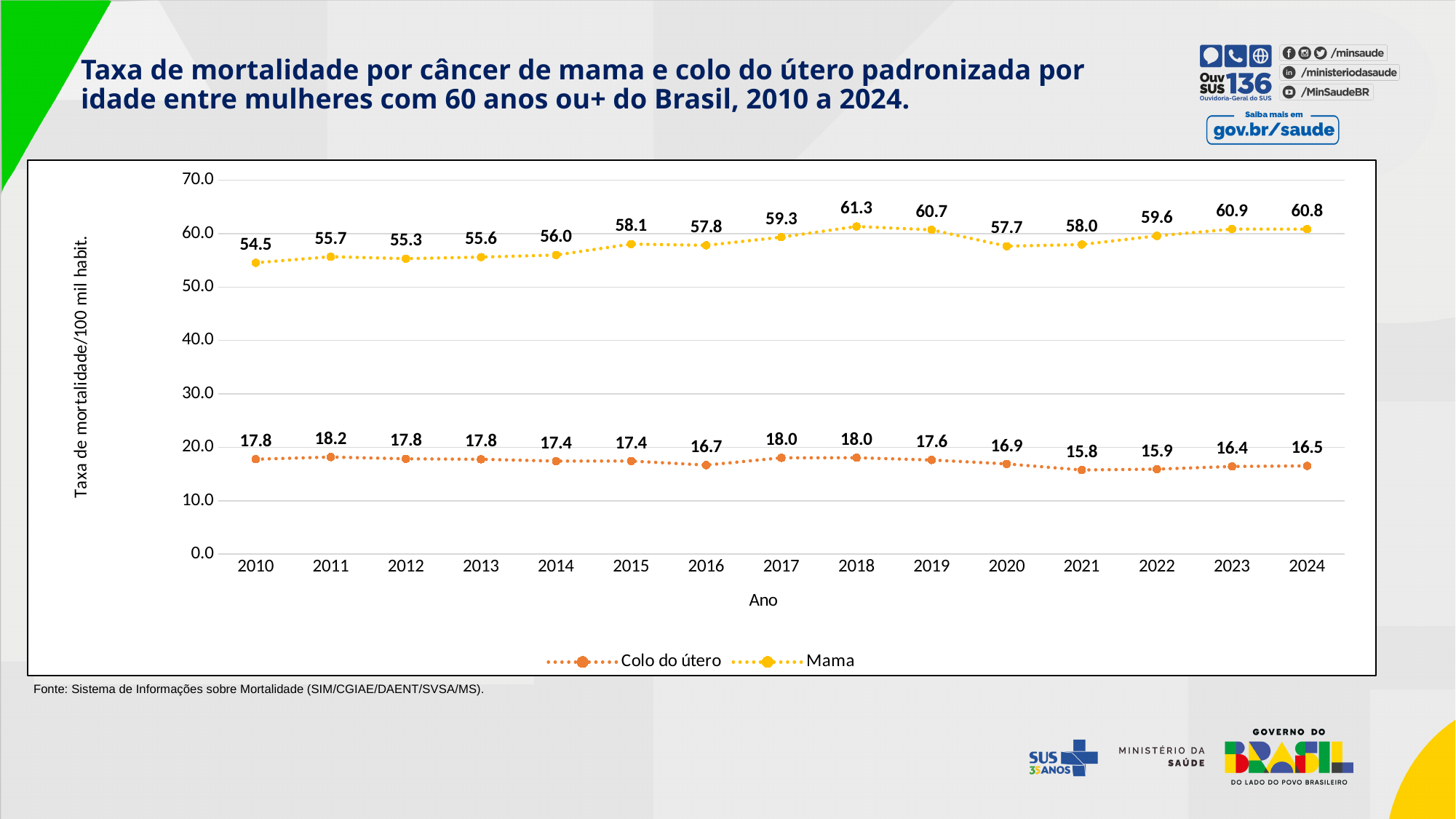
What is the Mama mortality rate in 2018? 61.3 What kind of chart is shown on the slide? line chart What is the Mama mortality rate in 2010? 54.5 How many years are shown on the x axis? 15 In which year is the Mama mortality rate highest? 2018 What is the label of the y axis? Taxa de mortalidade/100 mil habit. In which year is the Colo do útero mortality rate lowest? 2021 Which is larger, the Colo do útero rate in 2011 or in 2016? 2011 What is the difference between the Mama rate in 2024 and in 2010? 6.3 How many series does the legend list? 2 Is the Mama mortality rate in 2020 greater or less than 50.0? greater What is the Colo do útero mortality rate in 2021? 15.8